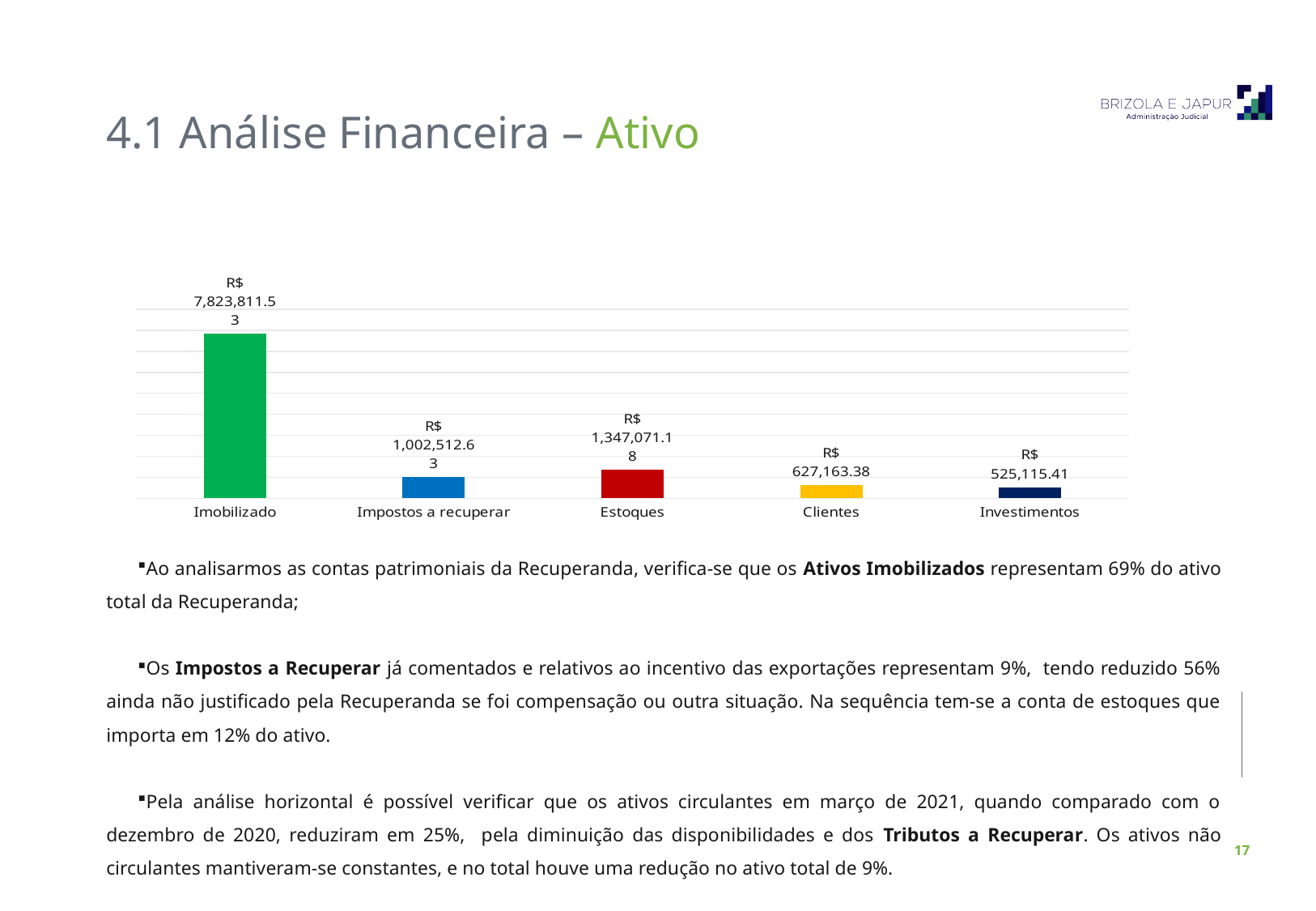
Which category has the highest value? Imobilizado Which category has the lowest value? Investimentos What kind of chart is shown on the slide? Bar chart What is the value for Clientes? R$ 627,163.38 What is the value for Impostos a recuperar? R$ 1,002,512.63 What is the difference between the values for Estoques and Impostos a recuperar? R$ 344,558.55 What is the value for Investimentos? R$ 525,115.41 What is the difference between the values for Clientes and Investimentos? R$ 102,047.97 How many categories are shown in the chart? 5 What is the value for Imobilizado? R$ 7,823,811.53 Which is larger, the value for Estoques or the value for Impostos a recuperar? Estoques What is the value for Estoques? R$ 1,347,071.18